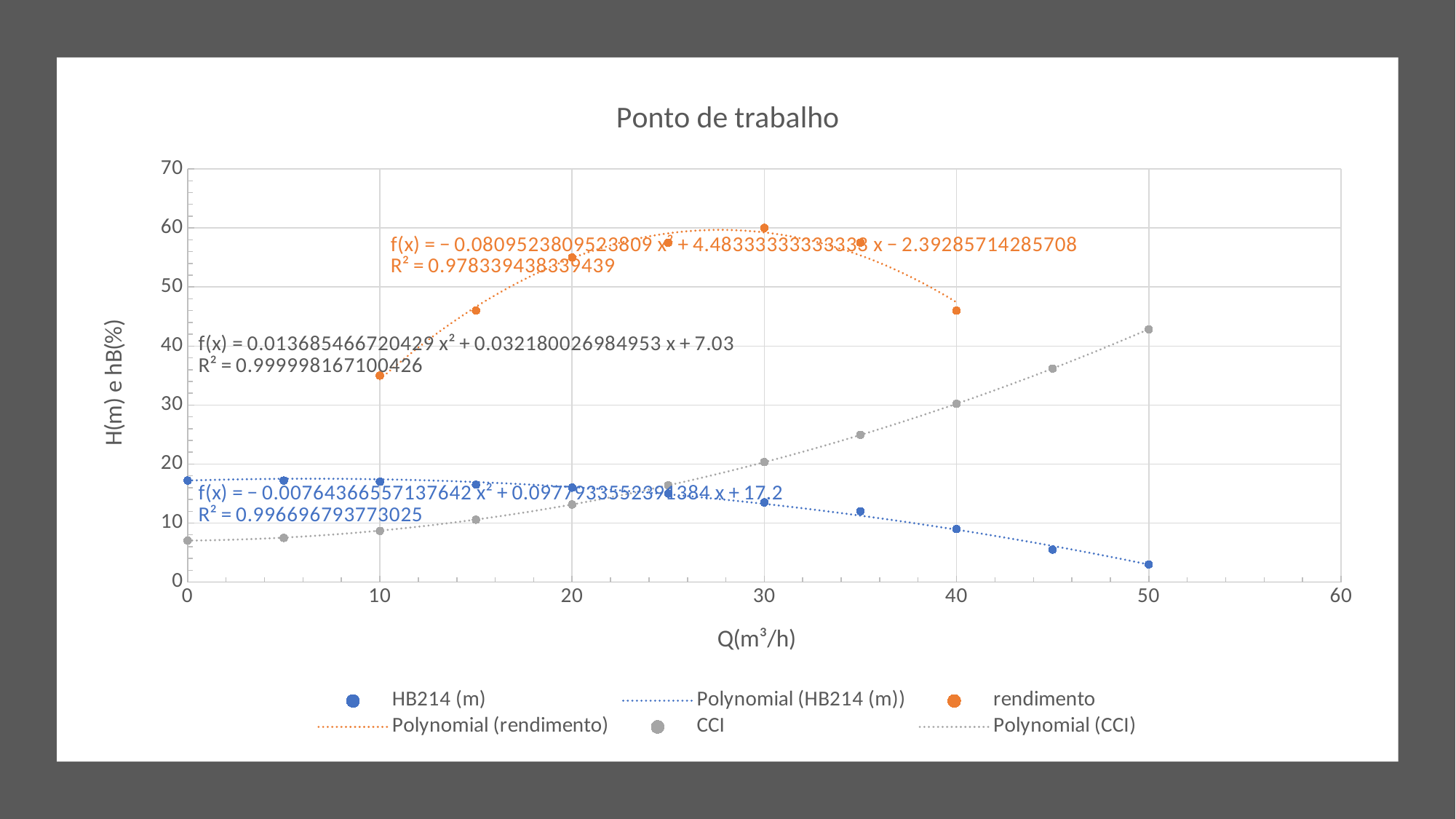
At which Q value is the HB214 (m) series lowest? 50 Is the rendimento value at Q = 30 greater or less than 50? greater At which Q value does the rendimento series reach its highest point? 30 Is the CCI value at Q = 50 greater or less than 40? greater How many data points are plotted for the CCI series? 11 Do the CCI values rise or fall as Q increases? rise At Q = 40, which series has the larger value, rendimento or CCI? rendimento What is the title of the chart? Ponto de trabalho How many data points are plotted for the rendimento series? 7 What kind of chart is shown on the slide? scatter chart How many entries does the chart legend list? 6 What is the label of the x axis? Q(m³/h)